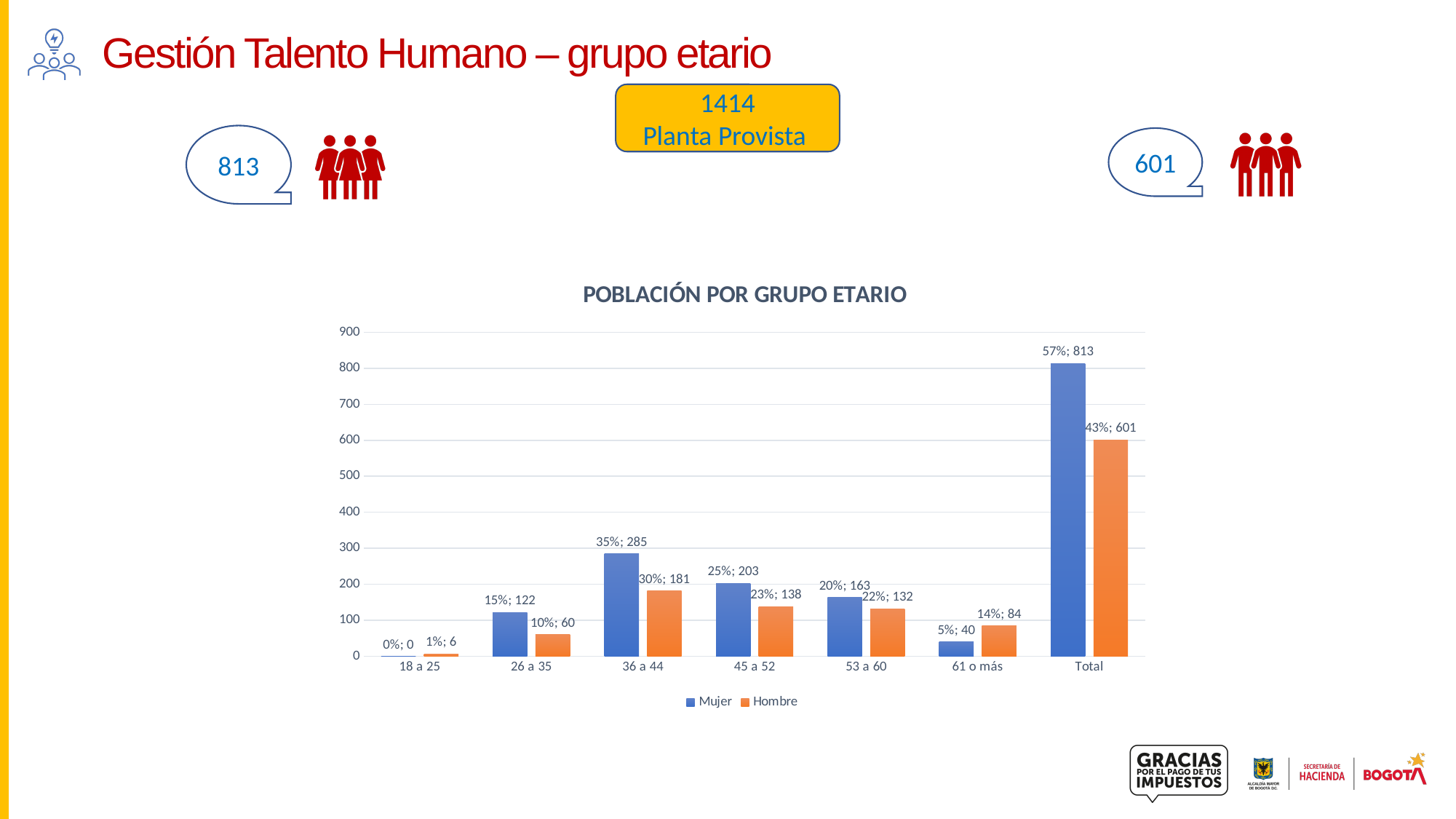
How many categories are shown on the x axis? 7 How many series does the legend list? 2 Is the Mujer value for the 53 a 60 group greater or less than 200? less What data label is shown for Hombre in the 61 o más group? 14%; 84 What is the Mujer value for the 36 a 44 group? 285 What is the difference between the Mujer and Hombre values in the Total category? 212 What is the Hombre value for the 45 a 52 group? 138 In the 61 o más group, which is larger, Mujer or Hombre? Hombre Excluding the Total category, which age group has the lowest Hombre value? 18 a 25 What type of chart is shown on the slide? bar chart Excluding the Total category, which age group has the highest Mujer value? 36 a 44 What is the chart's title? POBLACIÓN POR GRUPO ETARIO